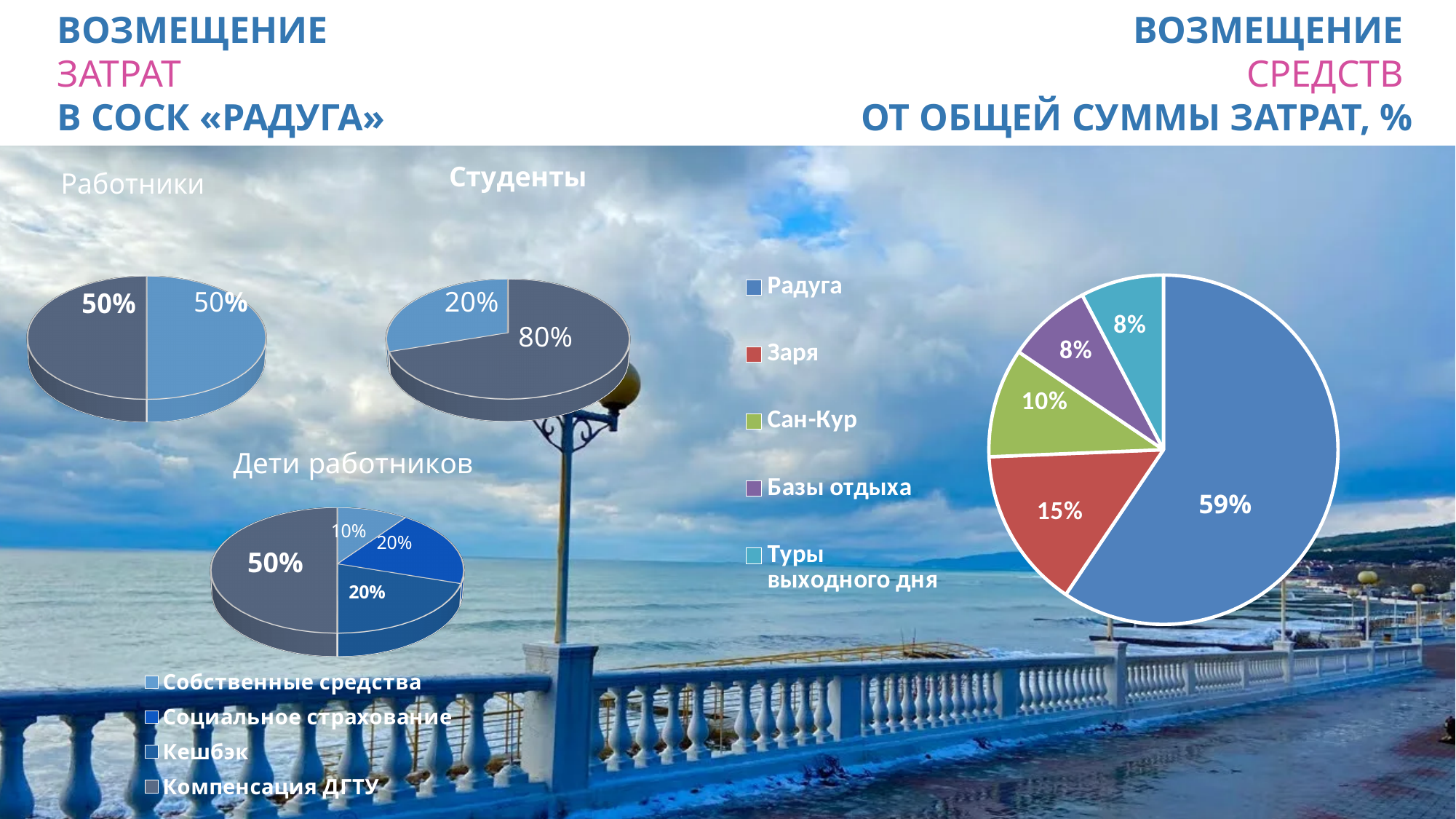
In the pie chart titled «Возмещение средств от общей суммы затрат, %», what share does Сан-Кур have? 10% In the pie chart titled «Возмещение средств от общей суммы затрат, %», which category has the largest share? Радуга In the pie chart titled «Возмещение средств от общей суммы затрат, %», how many entries does the legend list? 5 In the pie chart titled «Возмещение средств от общей суммы затрат, %», what share does Заря have? 15% In the pie chart titled «Возмещение средств от общей суммы затрат, %», what is the difference between the shares of Радуга and Заря? 44% In the pie chart titled «Работники», what value is shown for each of the two slices? 50% In the pie chart titled «Возмещение средств от общей суммы затрат, %», what share does Радуга have? 59% In the pie chart titled «Студенты», what is the smaller slice's value? 20% In the pie chart titled «Возмещение средств от общей суммы затрат, %», which is larger: the share of Сан-Кур or the share of Базы отдыха? Сан-Кур In the pie chart titled «Студенты», what is the larger slice's value? 80% How many slices does the pie chart titled «Дети работников» have? 4 What type of chart is used for «Дети работников»? Pie chart